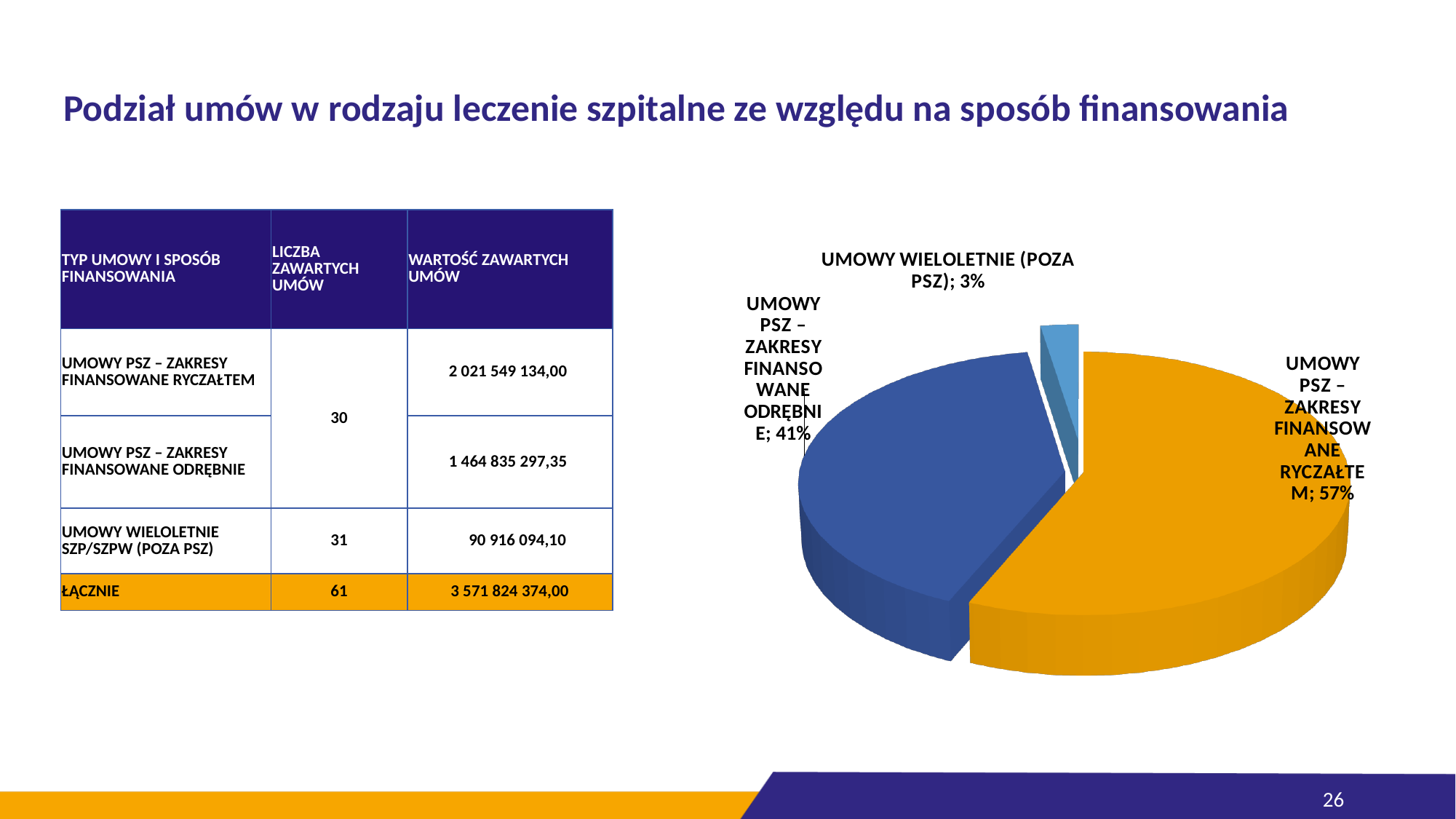
What kind of chart is shown on the slide? pie chart What share of the pie does UMOWY WIELOLETNIE (POZA PSZ) have? 3% Which slice of the pie chart is the largest? UMOWY PSZ – ZAKRESY FINANSOWANE RYCZAŁTEM Which slice of the pie chart is the smallest? UMOWY WIELOLETNIE (POZA PSZ) What share of the pie does UMOWY PSZ – ZAKRESY FINANSOWANE ODRĘBNIE have? 41% Which is larger in the pie chart: UMOWY PSZ – ZAKRESY FINANSOWANE ODRĘBNIE or UMOWY WIELOLETNIE (POZA PSZ)? UMOWY PSZ – ZAKRESY FINANSOWANE ODRĘBNIE How many slices does the pie chart have? 3 What share of the pie does UMOWY PSZ – ZAKRESY FINANSOWANE RYCZAŁTEM have? 57% What is the difference in percentage points between the UMOWY PSZ – ZAKRESY FINANSOWANE RYCZAŁTEM slice and the UMOWY PSZ – ZAKRESY FINANSOWANE ODRĘBNIE slice? 16 What colour is the largest slice of the pie chart? orange What colour is the UMOWY PSZ – ZAKRESY FINANSOWANE ODRĘBNIE slice? blue What is the difference in percentage points between the UMOWY PSZ – ZAKRESY FINANSOWANE ODRĘBNIE slice and the UMOWY WIELOLETNIE (POZA PSZ) slice? 38